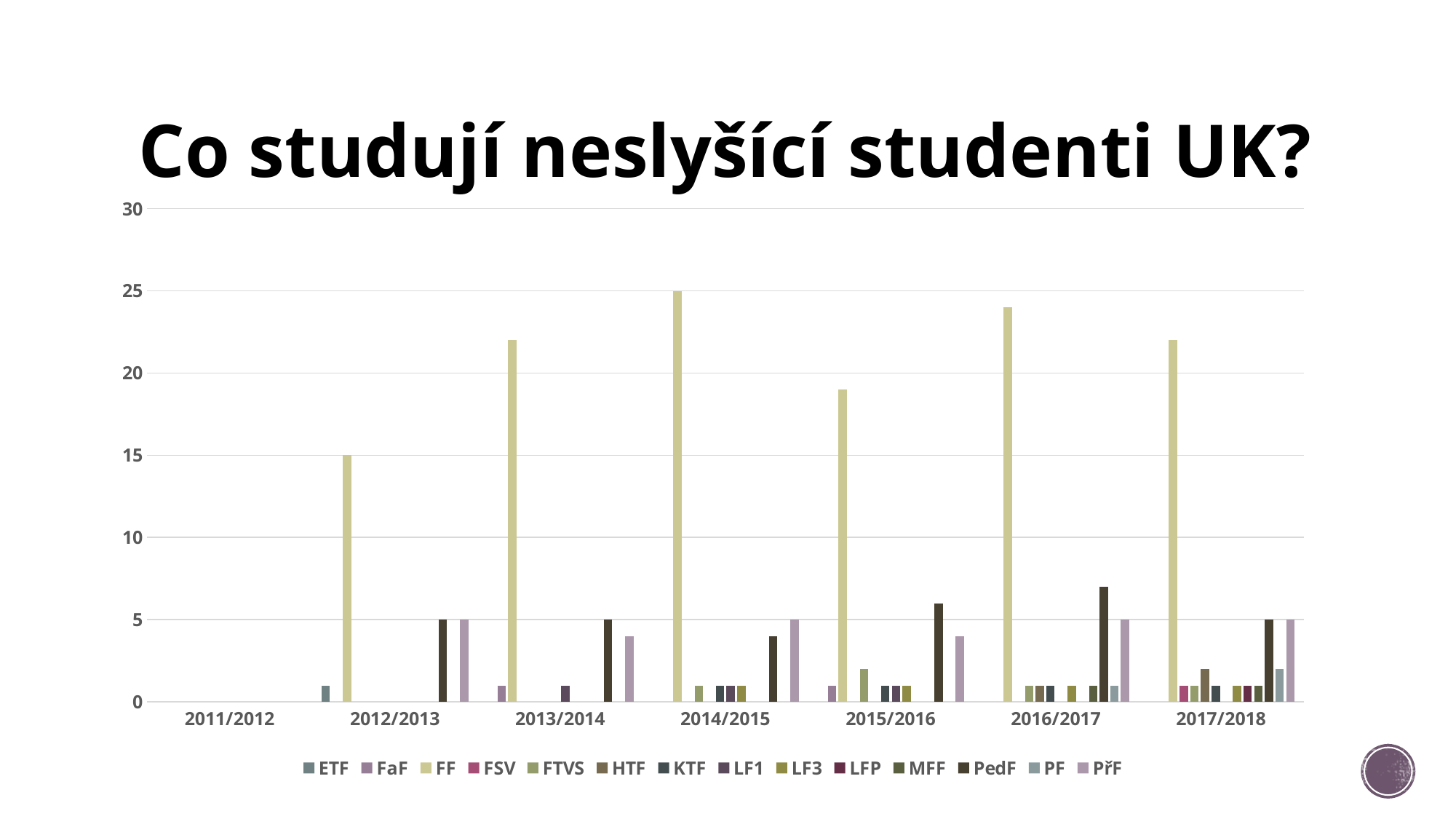
Is the value for FF in 2013/2014 greater or less than 20? greater What is the value for PedF in 2012/2013? 5 Is the value for FF in 2015/2016 greater or less than 20? less Is the value for PedF in 2016/2017 greater or less than 5? greater What is the value for FF in 2012/2013? 15 What is the value for FF in 2014/2015? 25 How many academic years are shown on the x axis? 7 What is the title of the chart? Co studují neslyšící studenti UK? What kind of chart is shown on the slide? bar chart How many series does the legend list? 14 In which year is the FF bar the highest? 2014/2015 Which series has the tallest bar in every year where bars are shown? FF